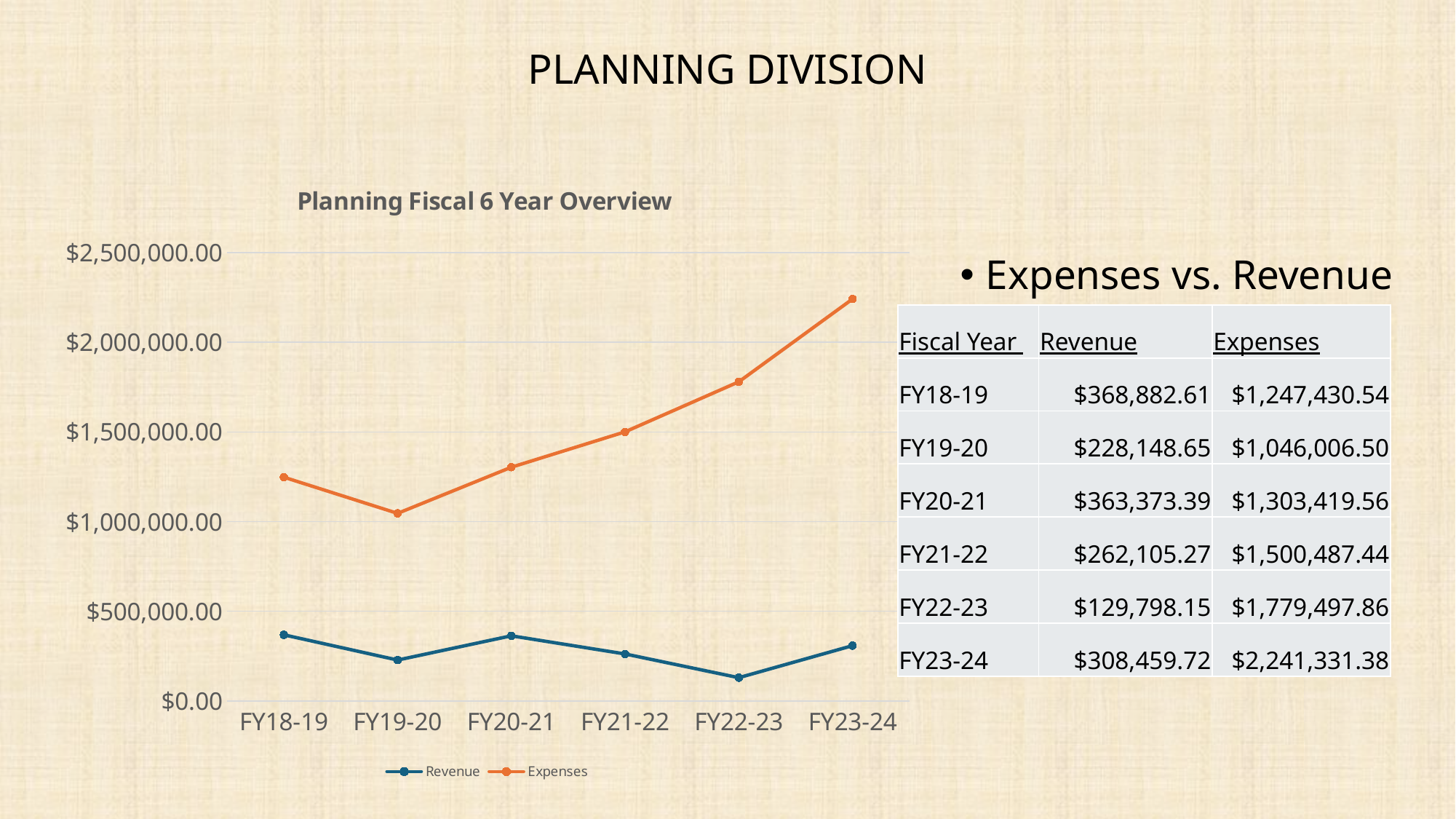
What type of chart is shown on the slide? Line chart In which fiscal year are Expenses highest? FY23-24 Do Expenses rise or fall from FY19-20 to FY23-24? Rise What is the Revenue value for FY19-20? $228,148.65 What is the difference between Expenses and Revenue in FY23-24? $1,932,871.66 Is the Expenses value for FY22-23 greater or less than $1,500,000.00? greater Which is larger in FY20-21, Revenue or Expenses? Expenses What is the Expenses value for FY23-24? $2,241,331.38 How many fiscal years are plotted on the x axis? 6 In which fiscal year is Revenue lowest? FY22-23 How many series does the chart legend list? 2 What is the title of the chart? Planning Fiscal 6 Year Overview